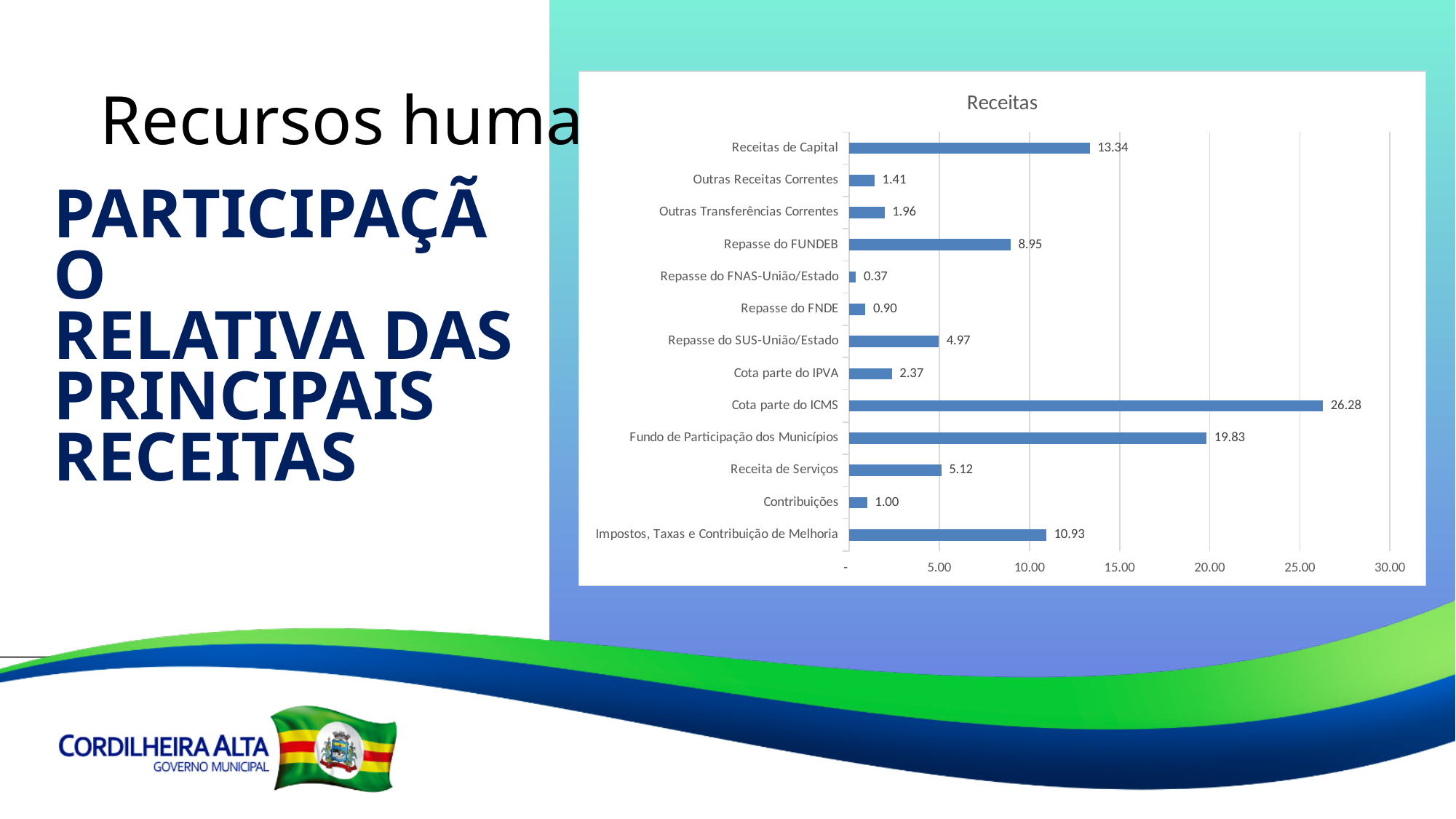
What is the value for Cota parte do ICMS? 26.28 Which is larger, the value for Receita de Serviços or the value for Repasse do SUS-União/Estado? Receita de Serviços Which category has the highest value? Cota parte do ICMS What is the value for Impostos, Taxas e Contribuição de Melhoria? 10.93 Which category has the lowest value? Repasse do FNAS-União/Estado What is the value for Repasse do FUNDEB? 8.95 Is the value for Fundo de Participação dos Municípios greater or less than 15.00? greater What is the difference between the values for Receitas de Capital and Impostos, Taxas e Contribuição de Melhoria? 2.41 What is the value for Repasse do FNDE? 0.90 How many categories are shown in the chart? 13 What kind of chart is shown on the slide? Bar chart What is the difference between the values for Cota parte do ICMS and Fundo de Participação dos Municípios? 6.45